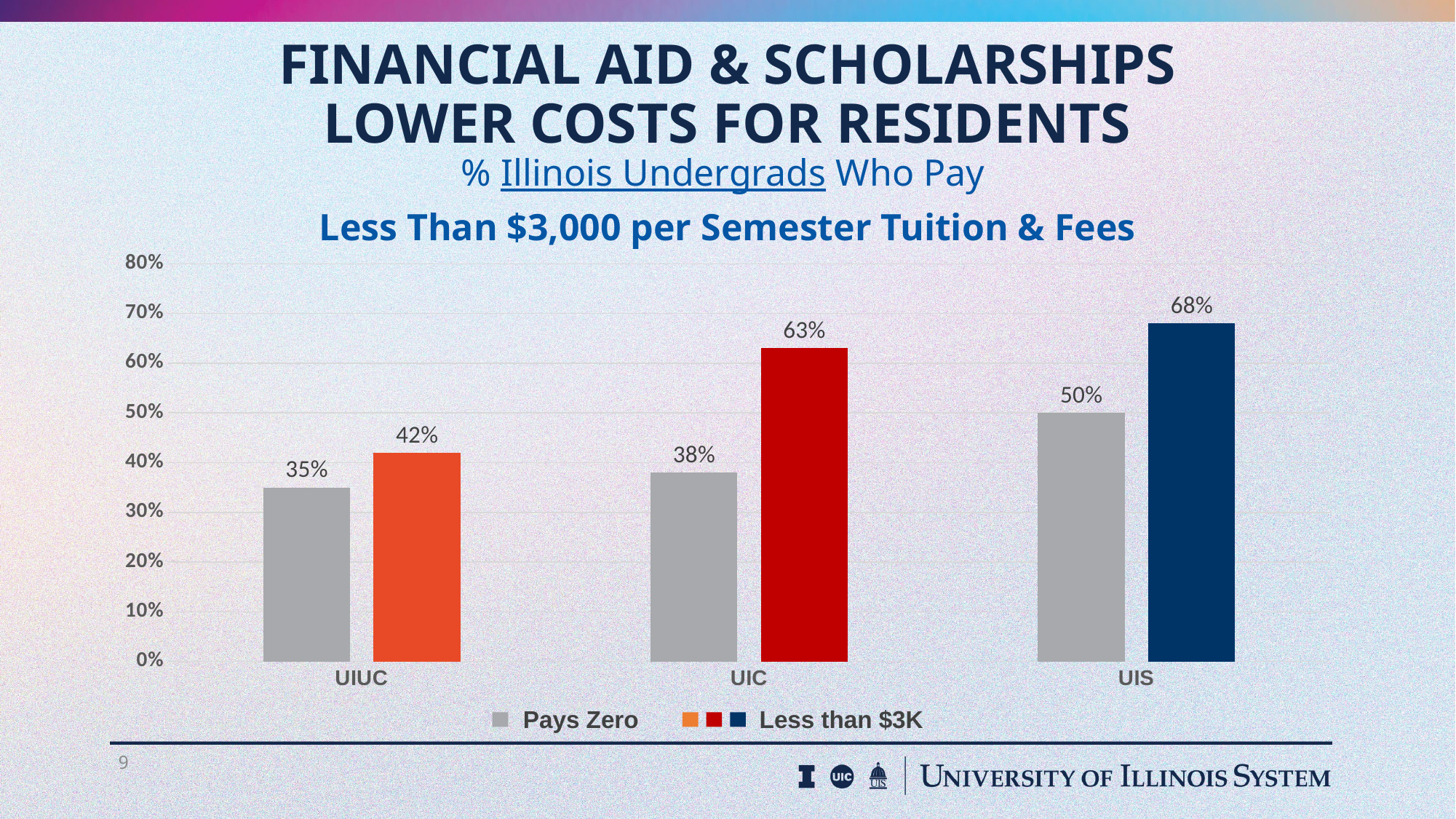
What is the difference between the Less than $3K and Pays Zero percentages for UIC? 25% Which is larger: the Pays Zero percentage for UIS or the Less than $3K percentage for UIUC? Pays Zero for UIS Which university has the highest percentage of undergrads paying less than $3K? UIS What percentage of UIS Illinois undergrads pay zero? 50% What kind of chart is shown on the slide? Bar chart How many universities are shown on the x axis of the chart? 3 How many series does the chart legend list? 2 What percentage of UIUC Illinois undergrads pay zero? 35% What colour are the Pays Zero bars in the chart? Gray Which university has the lowest percentage of undergrads paying zero? UIUC What percentage of UIC Illinois undergrads pay less than $3K? 63% What is the difference between the Less than $3K percentages for UIS and UIUC? 26%